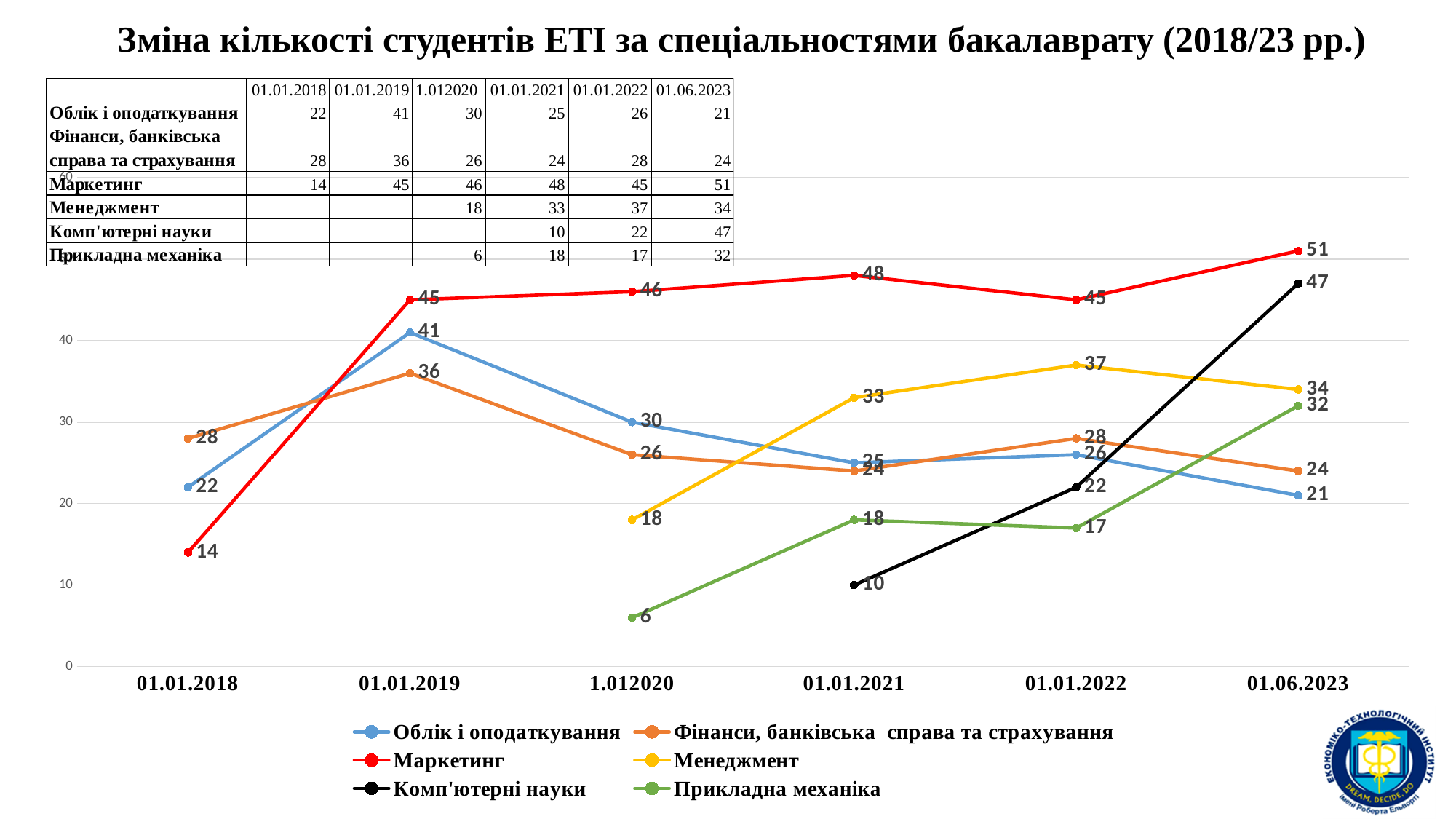
How many series does the legend list? 6 What is the value for Маркетинг on 01.06.2023? 51 Which series has the highest value on 01.06.2023? Маркетинг What is the difference between the Комп'ютерні науки values on 01.06.2023 and 01.01.2022? 25 How many dates are shown along the x axis? 6 What is the value for Облік і оподаткування on 01.01.2019? 41 What type of chart is shown on the slide? Line chart What colour is the line for Менеджмент? Yellow On 01.01.2018, which is larger: Фінанси, банківська справа та страхування or Маркетинг? Фінанси, банківська справа та страхування Which series has the lowest value on 1.012020? Прикладна механіка What is the value for Комп'ютерні науки on 01.01.2021? 10 Does the Комп'ютерні науки series rise or fall from 01.01.2021 to 01.06.2023? Rise